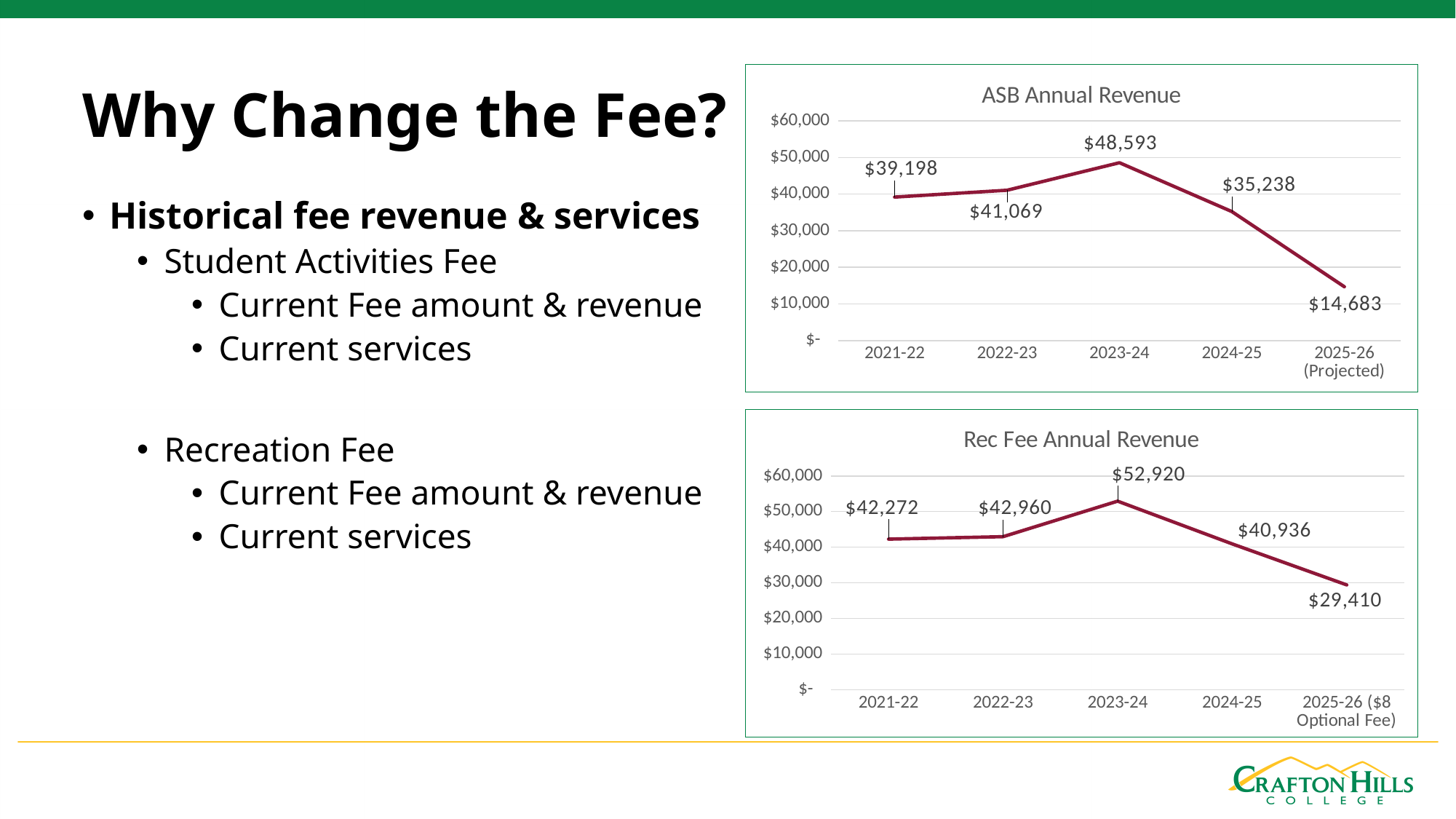
In the Rec Fee Annual Revenue chart, which is larger: the value for 2021-22 or the value for 2025-26 ($8 Optional Fee)? 2021-22 In the Rec Fee Annual Revenue chart, which year has the highest revenue? 2023-24 In the ASB Annual Revenue chart, which year has the lowest revenue? 2025-26 (Projected) In the ASB Annual Revenue chart, what is the difference between the 2023-24 and 2024-25 values? $13,355 In the Rec Fee Annual Revenue chart, what is the difference between the 2021-22 and 2022-23 values? $688 In the ASB Annual Revenue chart, what is the value for 2023-24? $48,593 In the Rec Fee Annual Revenue chart, do values rise or fall from 2023-24 to 2025-26 ($8 Optional Fee)? fall In the Rec Fee Annual Revenue chart, what is the value for 2024-25? $40,936 In the ASB Annual Revenue chart, how many data points are plotted? 5 In the ASB Annual Revenue chart, is the value for 2025-26 (Projected) greater or less than $20,000? less What is the title of the top chart on the slide? ASB Annual Revenue What type of chart is the Rec Fee Annual Revenue chart? line chart